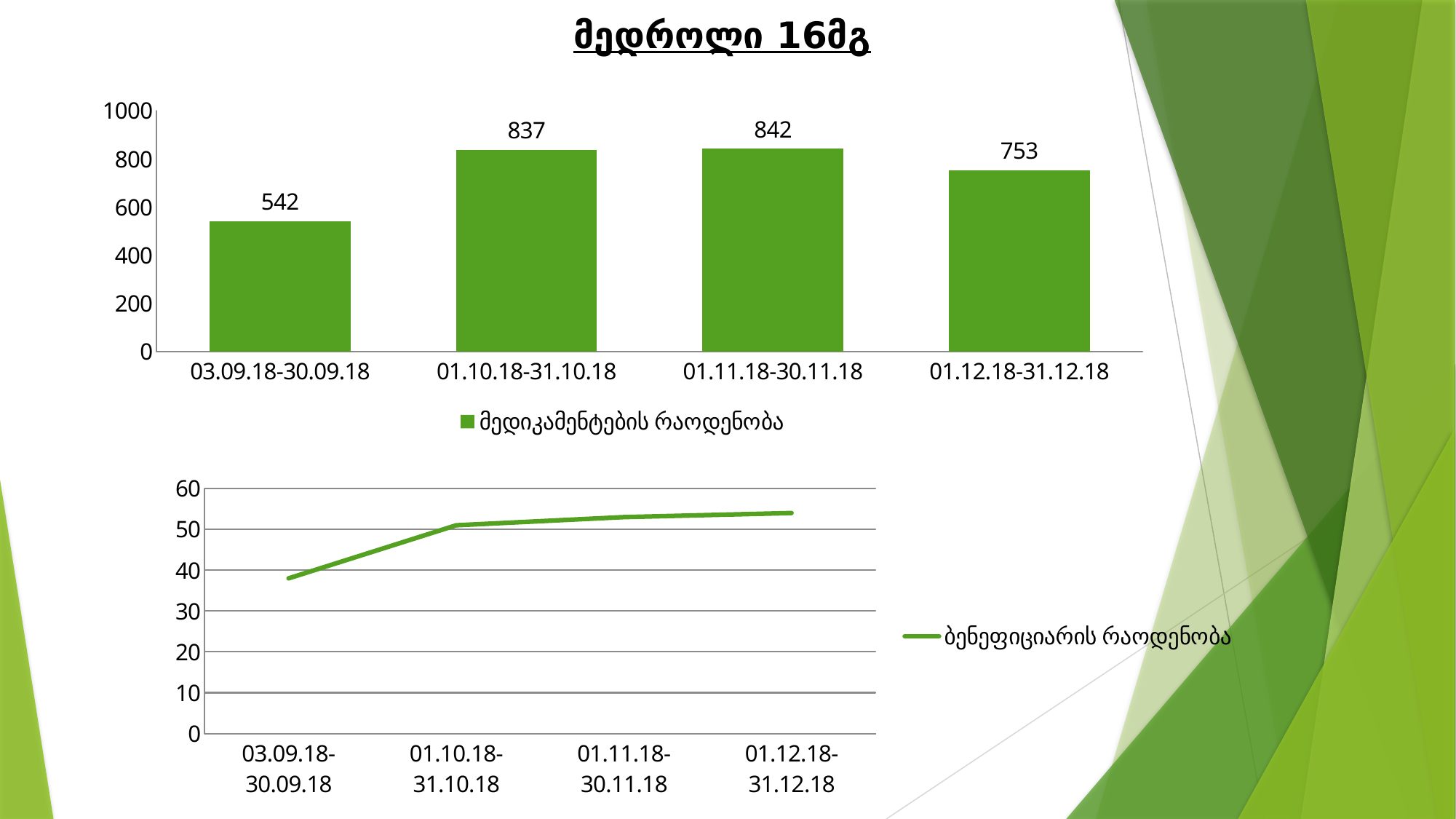
In the top bar chart, which period has the lowest value? 03.09.18-30.09.18 How many bars are in the top bar chart? 4 What type of chart is the bottom chart on the slide? Line chart In the top bar chart, what is the difference between the values for 01.10.18-31.10.18 and 03.09.18-30.09.18? 295 In the top bar chart, what is the value for 01.12.18-31.12.18? 753 What type of chart is the top chart on the slide? Bar chart What is the title of the slide above the charts? მედროლი 16მგ In the top bar chart, what is the value for 03.09.18-30.09.18? 542 In the top bar chart, which period has the highest value? 01.11.18-30.11.18 In the bottom line chart, do the values rise or fall from 03.09.18-30.09.18 to 01.12.18-31.12.18? rise In the bottom line chart, is the value for 03.09.18-30.09.18 greater or less than 40? less In the top bar chart, which is larger: the value for 01.10.18-31.10.18 or for 01.12.18-31.12.18? 01.10.18-31.10.18